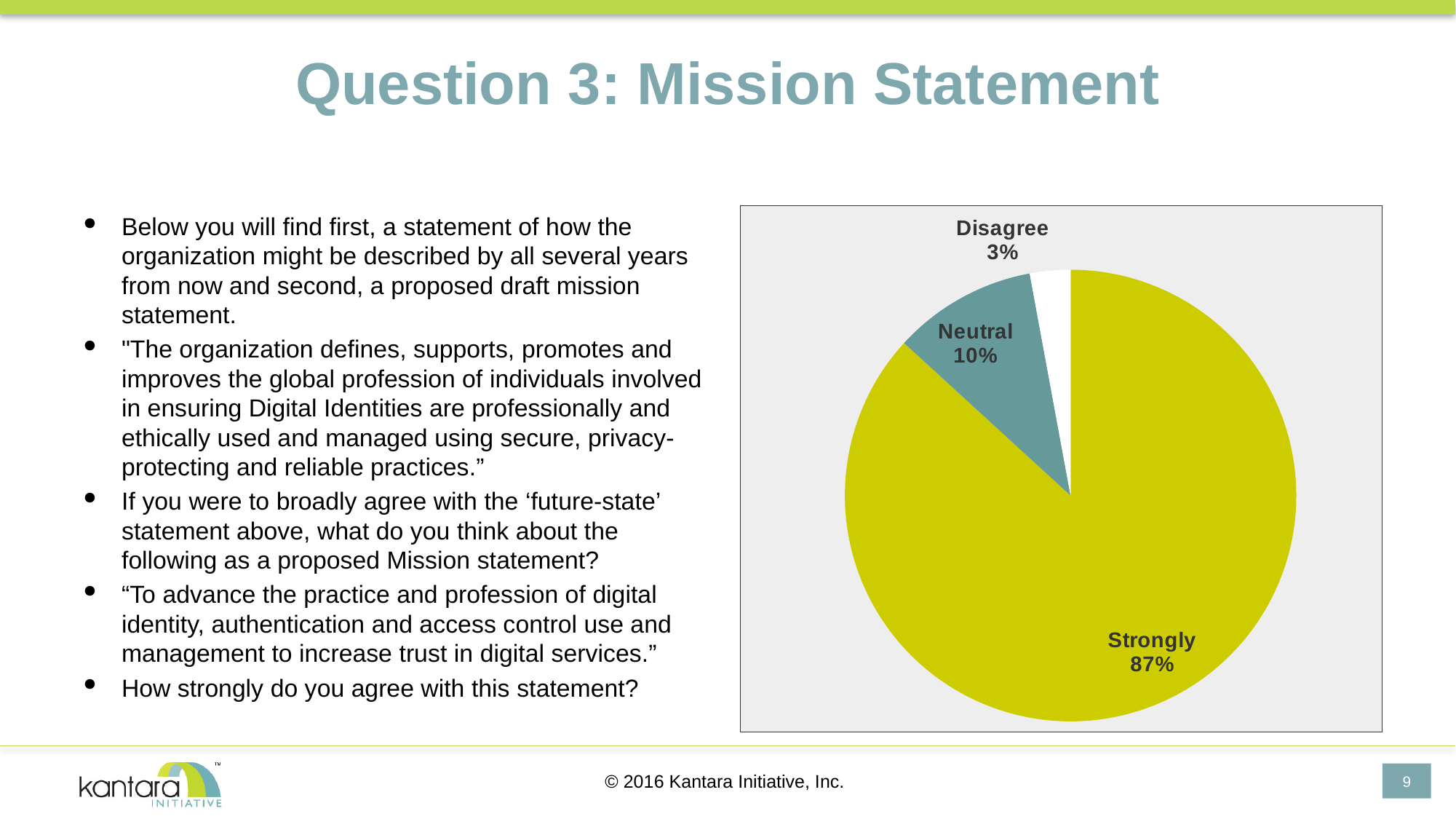
What is the difference in percentage points between the Neutral and Disagree slices? 7 What colour is the Neutral slice of the pie? teal Which slice of the pie is the smallest? Disagree What share of the pie is labelled Strongly? 87% What kind of chart is shown on the slide? pie chart Which slice of the pie is the largest? Strongly What is the difference in percentage points between the Strongly and Neutral slices? 77 What share of the pie is labelled Disagree? 3% How many slices does the pie chart have? 3 Which slice is larger, Neutral or Disagree? Neutral What colour is the Strongly slice of the pie? yellow-green What share of the pie is labelled Neutral? 10%